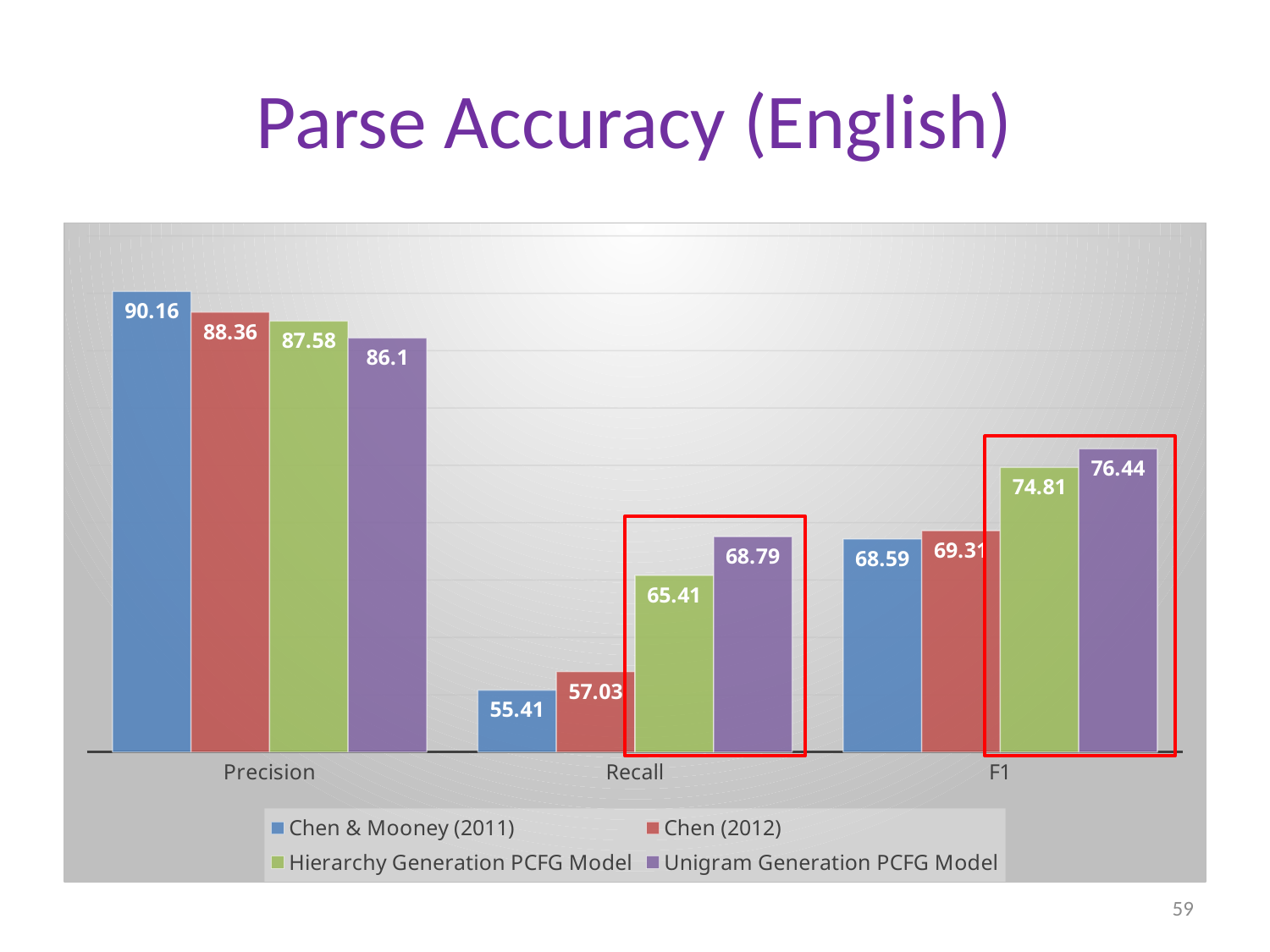
What is the Recall value for the Unigram Generation PCFG Model? 68.79 Which series has the highest F1 value? Unigram Generation PCFG Model How many categories are shown on the x axis? 3 Which series has the lowest Recall value? Chen & Mooney (2011) How many series does the legend list? 4 Which is larger: the F1 value for the Unigram Generation PCFG Model or the F1 value for Chen & Mooney (2011)? Unigram Generation PCFG Model What is the Recall value for Chen (2012)? 57.03 What is the Precision value for Chen & Mooney (2011)? 90.16 What is the F1 value for the Hierarchy Generation PCFG Model? 74.81 What is the difference between the Precision values of Chen & Mooney (2011) and the Unigram Generation PCFG Model? 4.06 What kind of chart is shown on the slide? Bar chart What is the title of the slide containing the chart? Parse Accuracy (English)